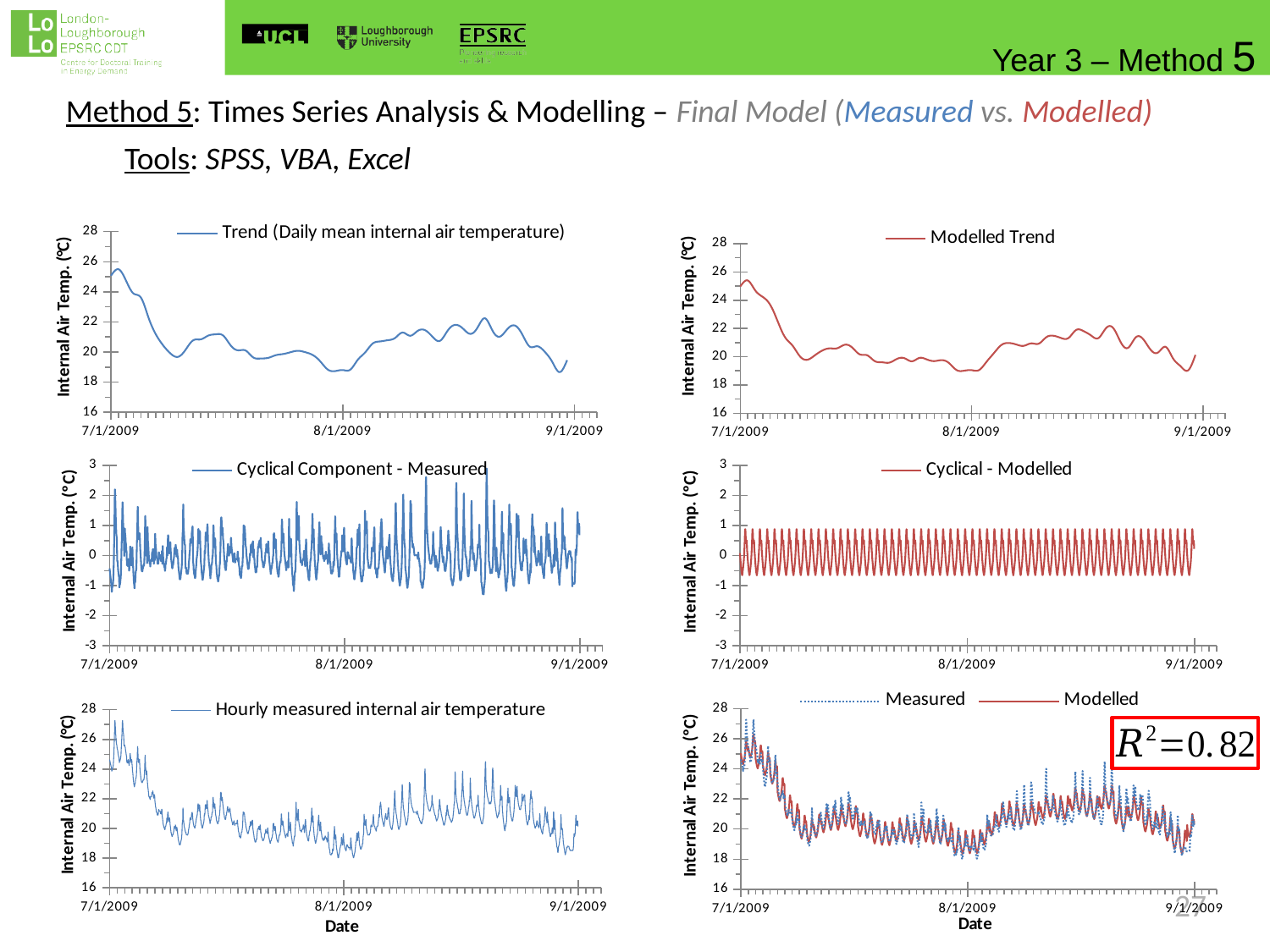
In the top-left chart 'Trend (Daily mean internal air temperature)', which is larger: the value at 7/1/2009 or the value at 9/1/2009? 7/1/2009 In the top-left chart 'Trend (Daily mean internal air temperature)', does the value rise or fall from 7/1/2009 to 8/1/2009? fall In the 'Cyclical - Modelled' chart, are the peak values greater or less than 1? less In the 'Cyclical Component - Measured' chart, is the highest peak greater or less than 2? greater What kind of chart is the top-left chart titled 'Trend (Daily mean internal air temperature)'? Line chart In the top-left chart 'Trend (Daily mean internal air temperature)', is the value at 8/1/2009 greater or less than 20? less What are the two legend entries of the bottom-right chart? Measured, Modelled What R-squared value is shown next to the bottom-right chart? 0.82 How many series does the legend of the bottom-right chart (Measured vs. Modelled) list? 2 How many charts are shown on the slide? 6 How many series does the legend of the top-left chart list? 1